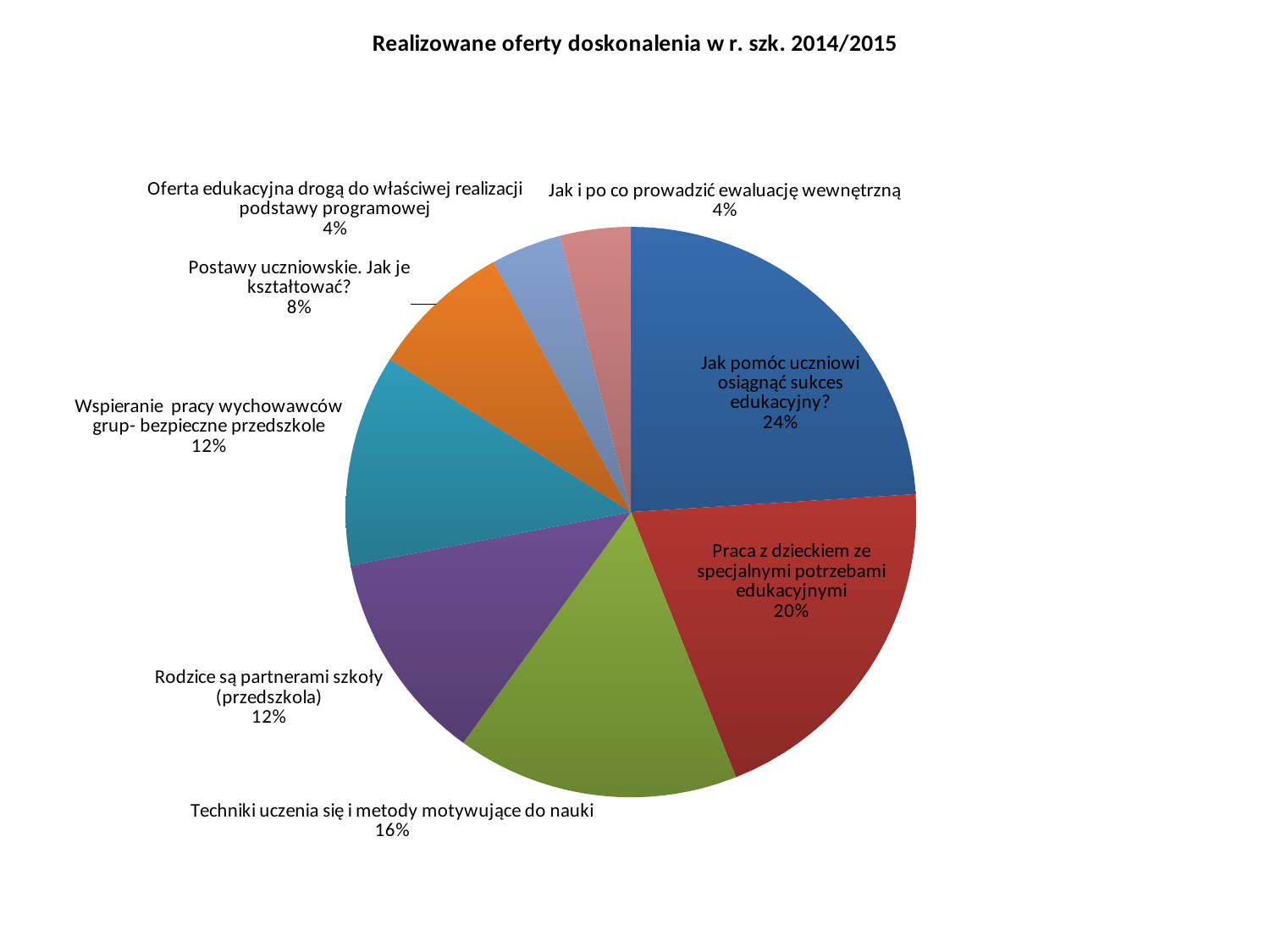
What is the difference in percentage points between "Jak pomóc uczniowi osiągnąć sukces edukacyjny?" and "Praca z dzieckiem ze specjalnymi potrzebami edukacyjnymi"? 4 percentage points Which is larger: the share for "Techniki uczenia się i metody motywujące do nauki" or the share for "Rodzice są partnerami szkoły (przedszkola)"? Techniki uczenia się i metody motywujące do nauki What is the title of the chart? Realizowane oferty doskonalenia w r. szk. 2014/2015 What kind of chart is shown on the slide? pie chart What share of the pie is "Praca z dzieckiem ze specjalnymi potrzebami edukacyjnymi"? 20% What share of the pie is "Postawy uczniowskie. Jak je kształtować?"? 8% Which category has the largest share of the pie? Jak pomóc uczniowi osiągnąć sukces edukacyjny? How many slices does the pie chart have? 8 What share of the pie is "Jak pomóc uczniowi osiągnąć sukces edukacyjny?"? 24%